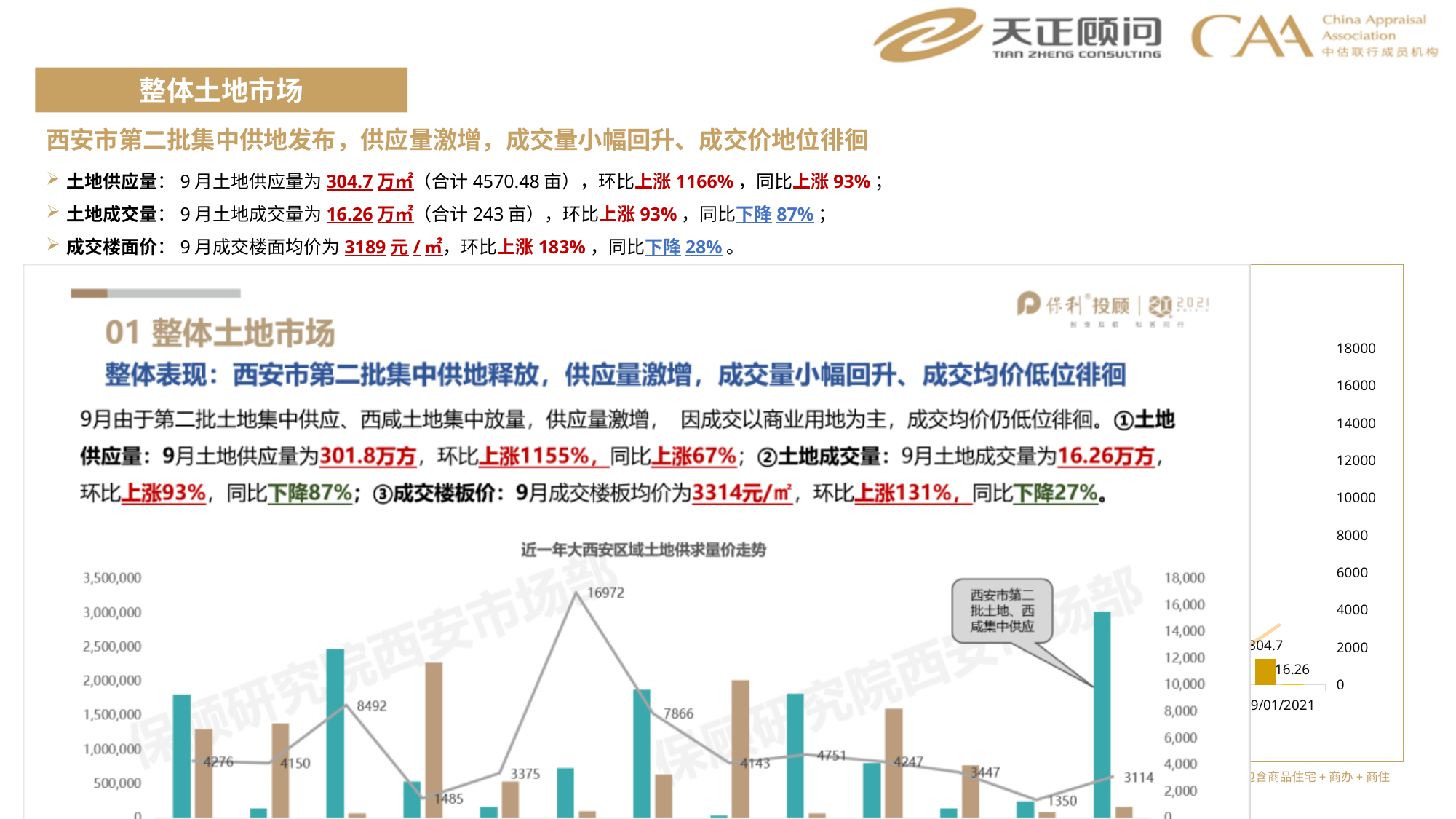
In the 近一年大西安区域土地供求量价走势 chart, which line label is larger, 4751 or 4143? 4751 In the 近一年大西安区域土地供求量价走势 chart, what is the difference between the line labels 4276 and 4150? 126 What kind of chart is the 近一年大西安区域土地供求量价走势 chart? bar chart with a line In the 近一年大西安区域土地供求量价走势 chart, which line label is larger, 8492 or 7866? 8492 In the 近一年大西安区域土地供求量价走势 chart, what does the callout box pointing to the tallest teal bar say? 西安市第二批土地、西咸集中供应 In the 近一年大西安区域土地供求量价走势 chart, does the line rise or fall between the labels 8492 and 1485? fall In the partially visible chart on the right edge of the slide, which two data labels are printed at 9/01/2021? 304.7 and 16.26 In the 近一年大西安区域土地供求量价走势 chart, what is the highest value labeled on the line? 16972 In the 近一年大西安区域土地供求量价走势 chart, what is the lowest value labeled on the line? 1350 What is the title of the chart in the embedded image on the slide? 近一年大西安区域土地供求量价走势 In the 近一年大西安区域土地供求量价走势 chart, what is the difference between the highest line label (16972) and the lowest line label (1350)? 15622 In the 近一年大西安区域土地供求量价走势 chart, how many data labels are printed on the line? 13